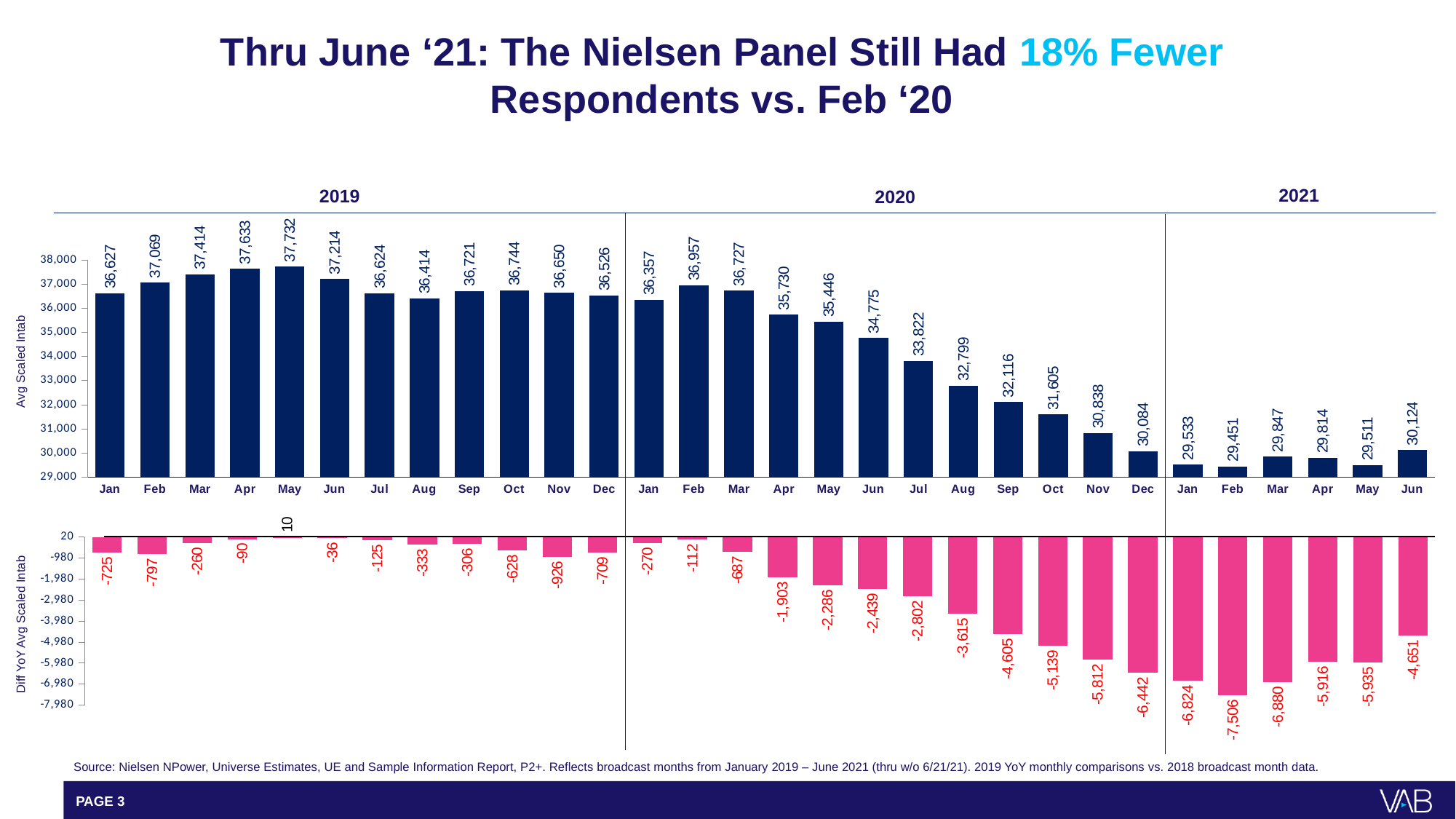
In the top chart (Avg Scaled Intab), what is the value for May 2019? 37,732 In the top chart (Avg Scaled Intab), which month has the lowest value? Feb 2021 In the top chart (Avg Scaled Intab), what is the value for Dec 2020? 30,084 In the top chart (Avg Scaled Intab), how many monthly bars are plotted? 30 What type of chart is the top chart (Avg Scaled Intab)? bar chart In the bottom chart (Diff YoY Avg Scaled Intab), which month is the only one with a positive value? May 2019 In the top chart (Avg Scaled Intab), which month has the highest value? May 2019 In the top chart (Avg Scaled Intab), what is the difference between Feb 2020 and Jun 2021? 6,833 In the bottom chart (Diff YoY Avg Scaled Intab), what is the value for Feb 2021? -7,506 In the bottom chart (Diff YoY Avg Scaled Intab), which month has the lowest value? Feb 2021 In the top chart (Avg Scaled Intab), which is larger, the value for Jun 2020 or the value for Jul 2020? Jun 2020 In the top chart (Avg Scaled Intab), do the values rise or fall from Mar 2020 through Dec 2020? fall